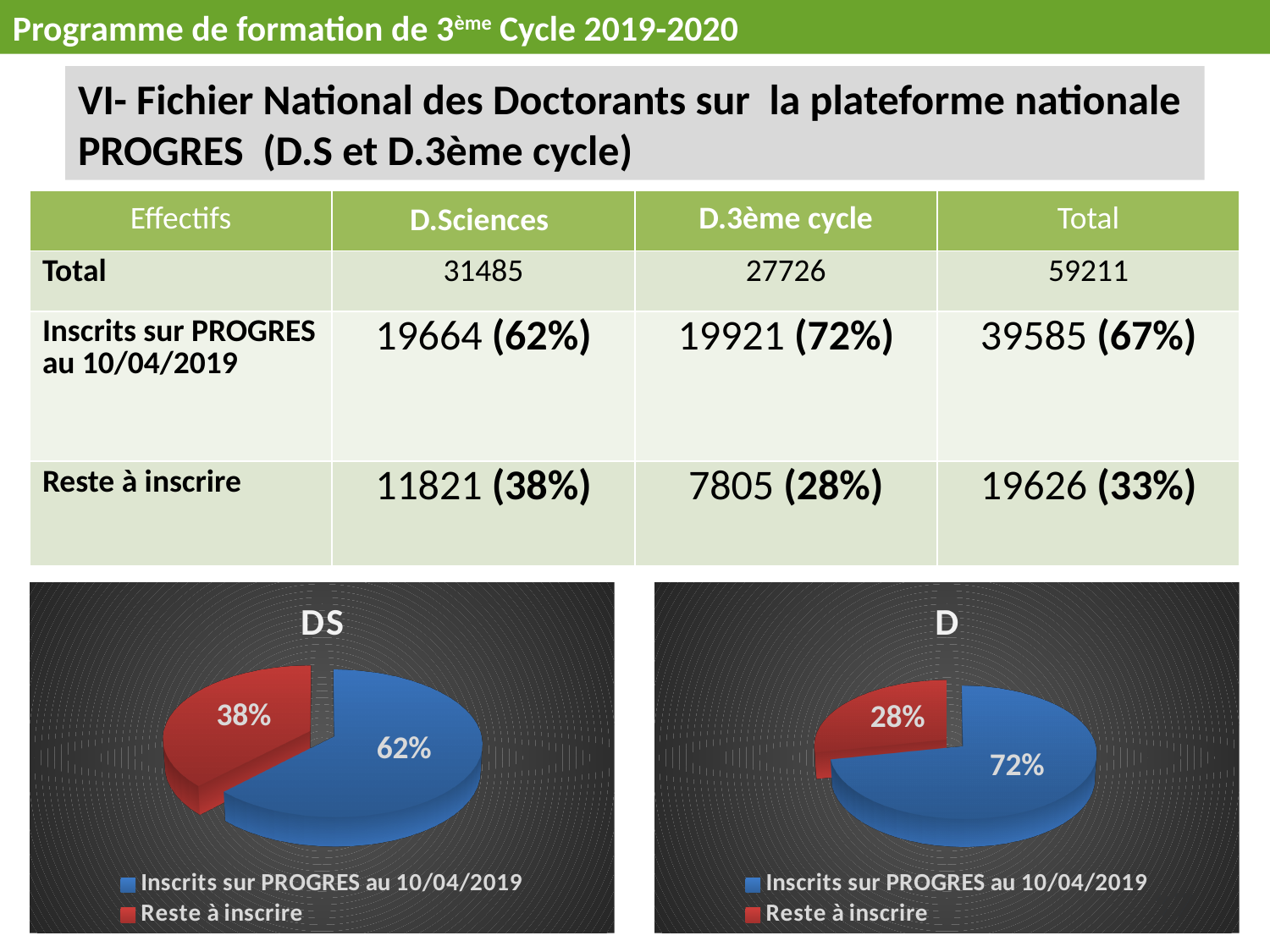
In the pie chart titled "D", what share is labelled for "Inscrits sur PROGRES au 10/04/2019"? 72% What type of chart is the chart titled "DS"? Pie chart In the pie chart titled "DS", what share is labelled for "Inscrits sur PROGRES au 10/04/2019"? 62% How many slices does the pie chart titled "D" have? 2 Which is larger: the "Reste à inscrire" share in the "DS" chart or in the "D" chart? DS In the pie chart titled "D", what share is labelled for "Reste à inscrire"? 28% In the pie chart titled "D", what is the difference in percentage points between the two slices? 44 In the pie chart titled "DS", what is the difference in percentage points between the two slices? 24 In the pie chart titled "DS", what colour is the "Reste à inscrire" slice? Red In the pie chart titled "D", which slice is the smallest? Reste à inscrire In the pie chart titled "DS", which slice is the largest? Inscrits sur PROGRES au 10/04/2019